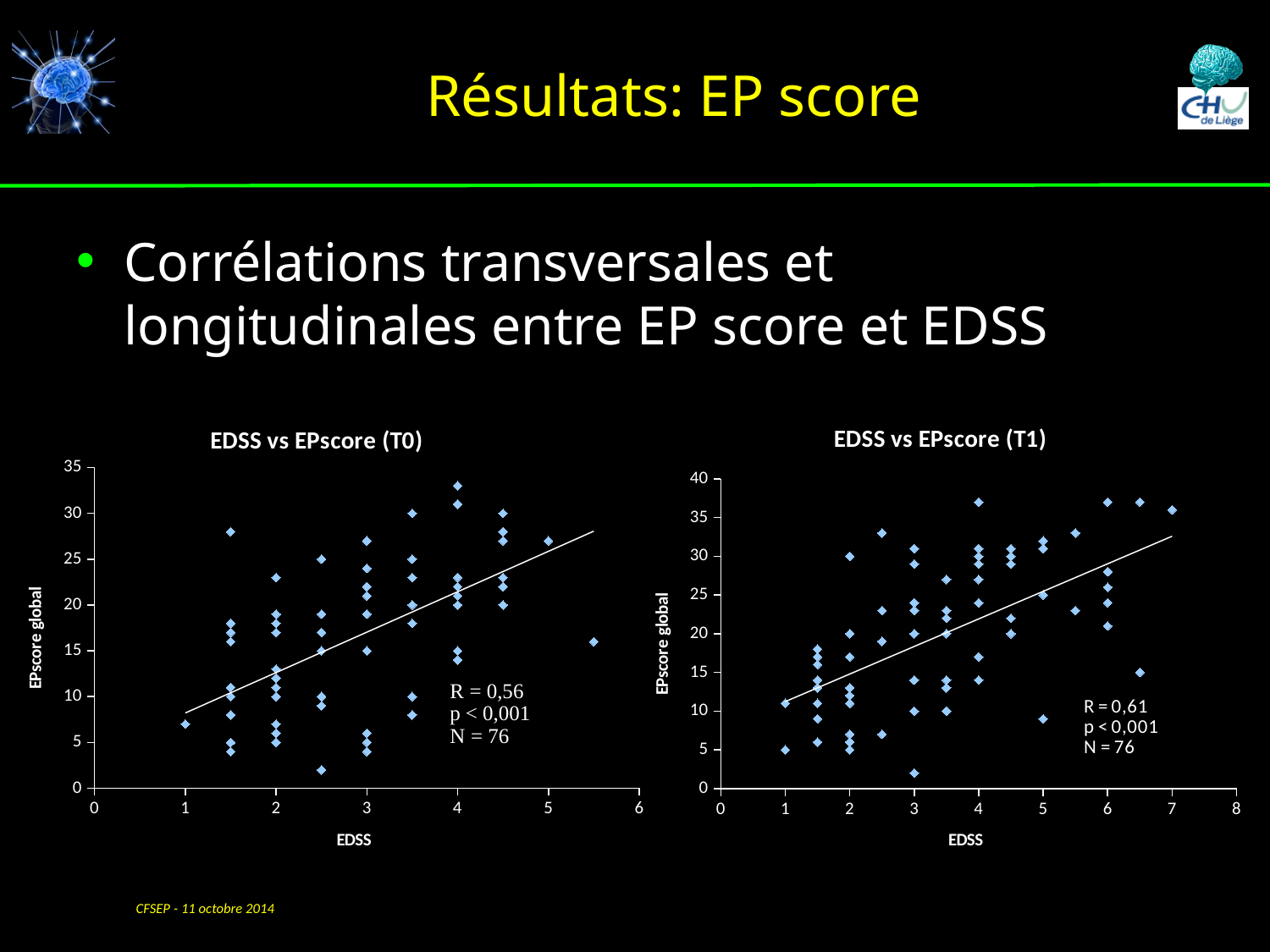
What kind of chart is the left chart, 'EDSS vs EPscore (T0)'? scatter chart In the chart 'EDSS vs EPscore (T0)', do the EPscore values tend to rise or fall as EDSS increases along the x axis? rise What is the highest value shown on the x axis of the chart 'EDSS vs EPscore (T1)'? 8 In the chart 'EDSS vs EPscore (T1)', do the EPscore values tend to rise or fall as EDSS increases along the x axis? rise In the chart 'EDSS vs EPscore (T0)', is the EPscore value of the point at EDSS 5 greater or less than 20? greater What correlation coefficient R is printed on the chart 'EDSS vs EPscore (T0)'? R = 0,56 What is the highest value shown on the y axis of the chart 'EDSS vs EPscore (T0)'? 35 In the chart 'EDSS vs EPscore (T0)', is the EPscore value of the point at EDSS 5.5 greater or less than 20? less In the chart 'EDSS vs EPscore (T1)', is the EPscore value of the point at EDSS 7 greater or less than 30? greater How many observations (N) does the chart 'EDSS vs EPscore (T1)' report? N = 76 What correlation coefficient R is printed on the chart 'EDSS vs EPscore (T1)'? R = 0,61